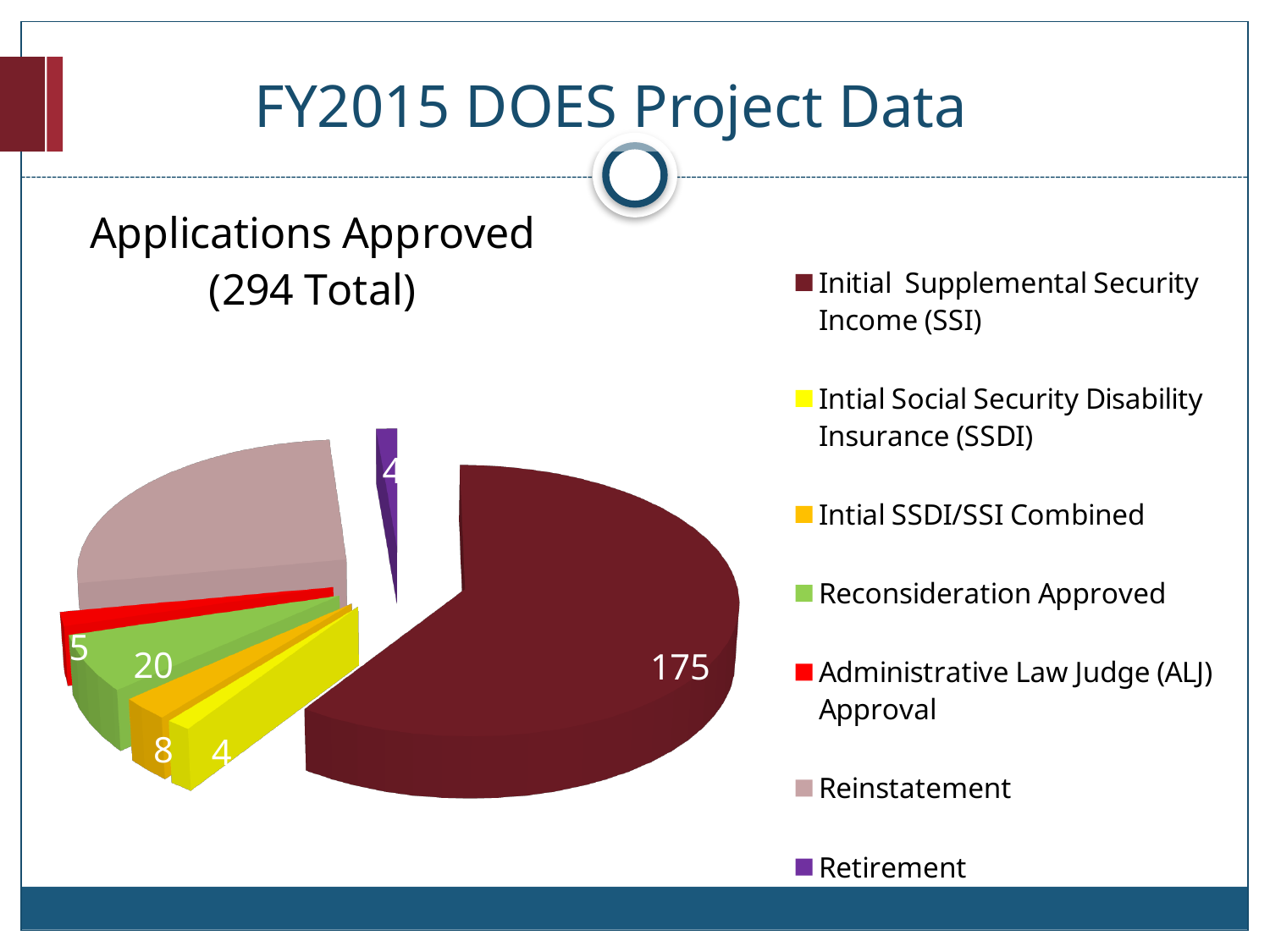
Which category has the largest slice of the pie? Initial Supplemental Security Income (SSI) Which is larger, Reconsideration Approved or Intial SSDI/SSI Combined? Reconsideration Approved What is the value for Intial SSDI/SSI Combined? 8 What is the total number of applications approved shown in the chart title? 294 What is the value for Reconsideration Approved? 20 What is the difference between Initial Supplemental Security Income (SSI) and Reconsideration Approved? 155 What is the value for Initial Supplemental Security Income (SSI)? 175 How many categories does the legend list? 7 What is the title of the chart? Applications Approved (294 Total) What is the value for Administrative Law Judge (ALJ) Approval? 5 What is the value for Retirement? 4 What type of chart is shown on the slide? Pie chart